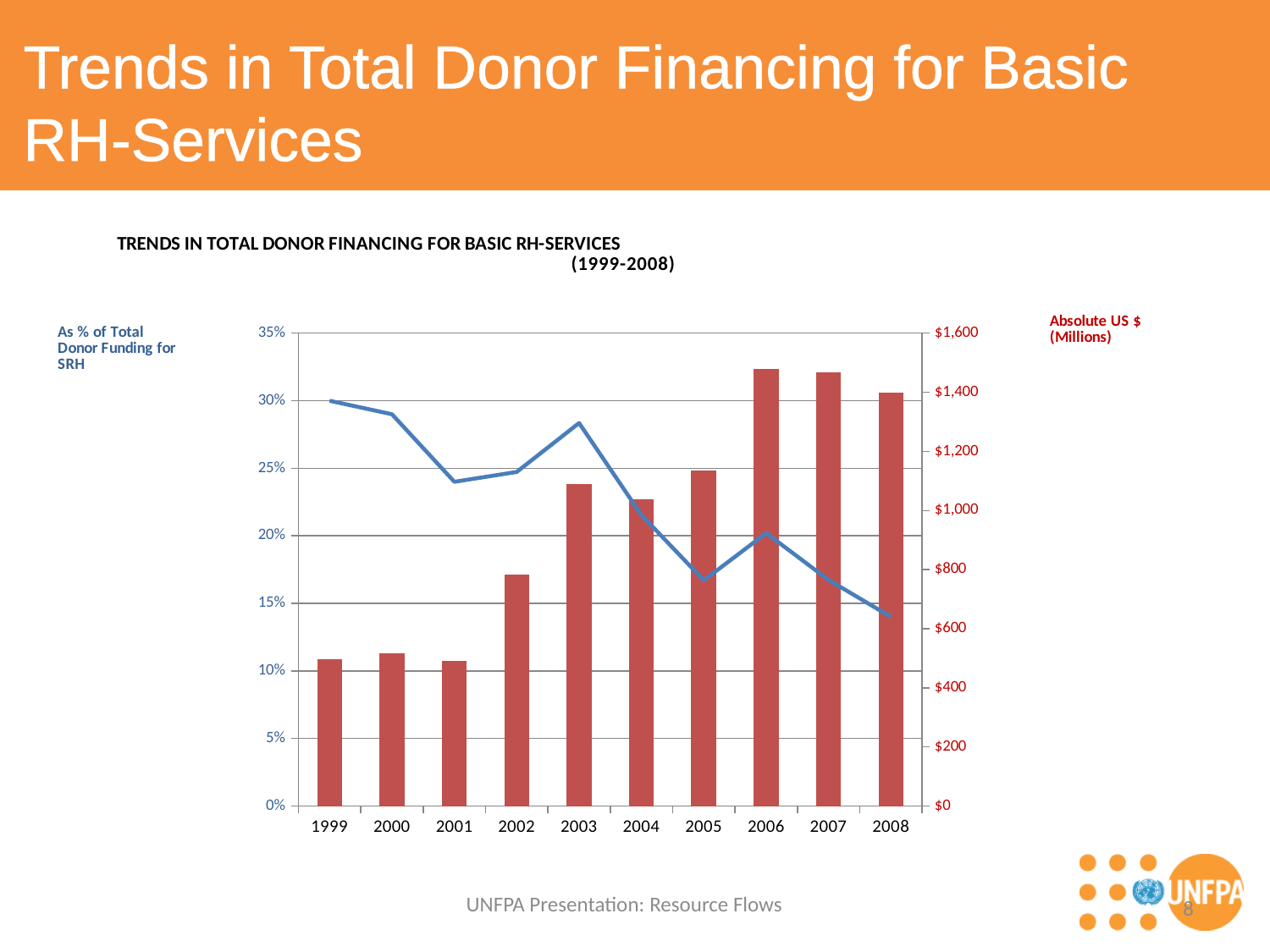
What is the label of the right-hand vertical axis of the chart? Absolute US $ (Millions) Is the 'As % of Total Donor Funding for SRH' line value for 1999 greater or less than 25%? greater Which year has the higher 'As % of Total Donor Funding for SRH' line value, 2003 or 2004? 2003 Is the absolute US$ (millions) bar for 2003 greater or less than $1,000? greater What kind of chart is shown on the slide? A combination bar and line chart Which year has the larger absolute US$ (millions) bar, 2002 or 2006? 2006 Overall, does the 'As % of Total Donor Funding for SRH' line rise or fall from 1999 to 2008? fall How many years are shown on the x axis of the chart? 10 Is the absolute US$ (millions) bar for 2006 greater or less than $1,400? greater In which year is the 'As % of Total Donor Funding for SRH' line at its lowest? 2008